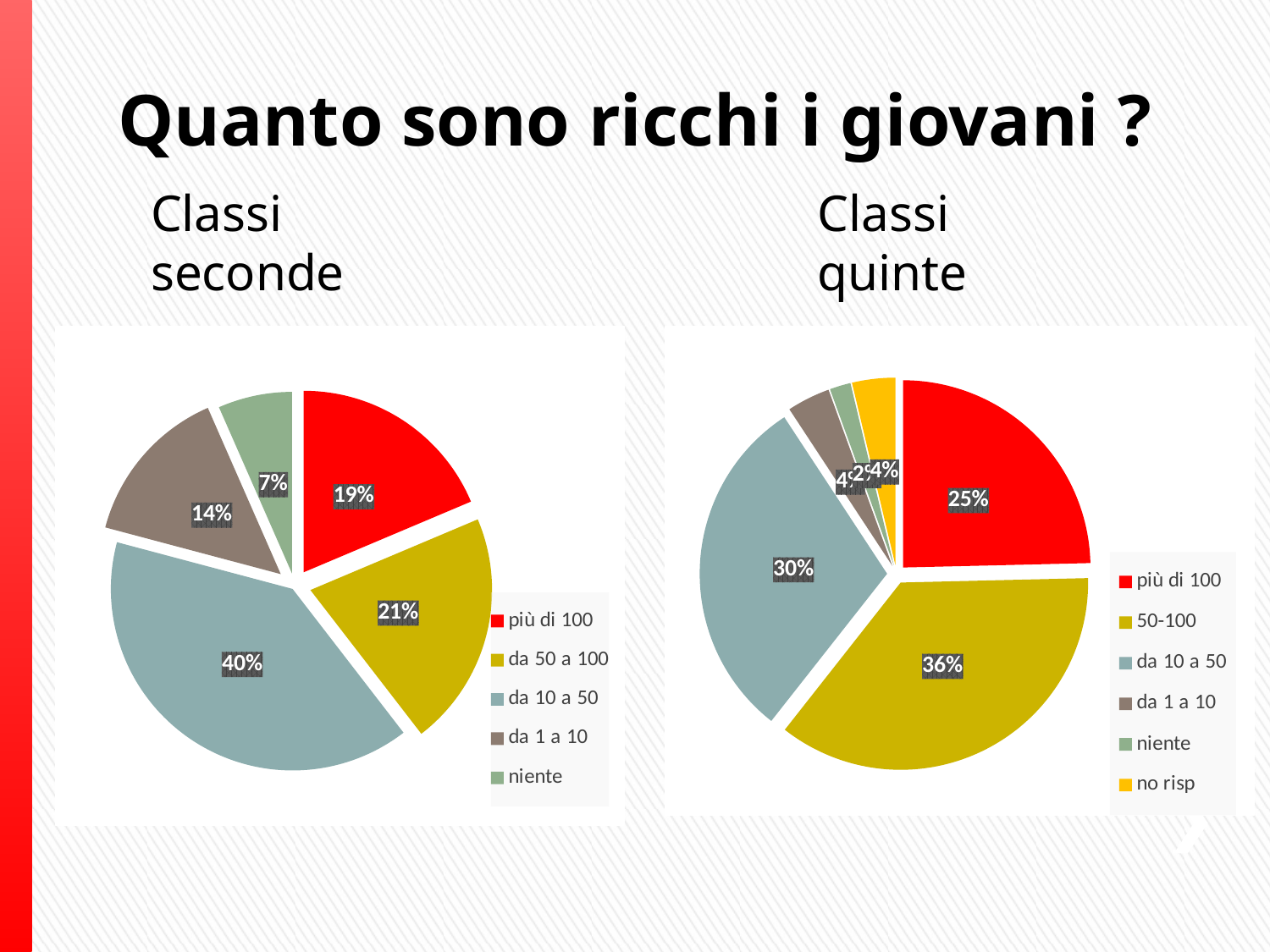
How many categories does the legend of the 'Classi quinte' chart list? 6 In the 'Classi seconde' pie chart, what share is labelled for 'da 10 a 50'? 40% In the 'Classi seconde' pie chart, which category has the largest slice? da 10 a 50 In the 'Classi quinte' pie chart, what share is labelled for '50-100'? 36% In the 'Classi seconde' pie chart, what is the difference between the 'da 50 a 100' and 'da 1 a 10' shares? 7% In the 'Classi quinte' pie chart, which category has the largest slice? 50-100 In the 'Classi quinte' pie chart, what share is labelled for 'più di 100'? 25% In the 'Classi quinte' pie chart, which is larger, 'da 10 a 50' or 'più di 100'? da 10 a 50 In the 'Classi seconde' pie chart, which category has the smallest slice? niente What type of chart is used for 'Classi seconde'? Pie chart In the 'Classi seconde' pie chart, what share is labelled for 'più di 100'? 19% In the 'Classi seconde' pie chart, what share is labelled for 'niente'? 7%